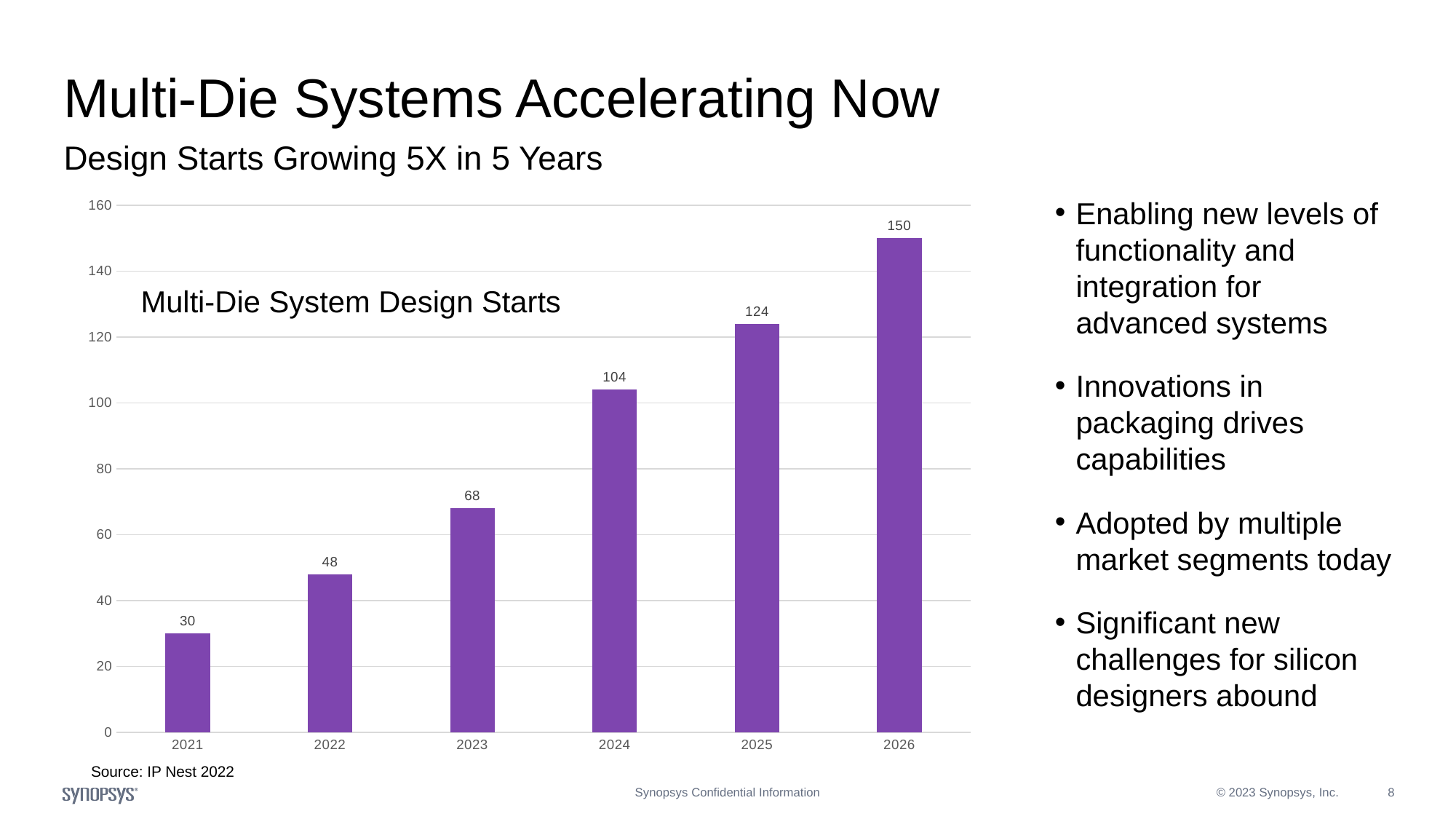
What kind of chart is shown on the slide? Bar chart Which year has the lowest value in the chart? 2021 Which is larger, the value for 2023 or the value for 2022? 2023 What is the value for 2021 in the Multi-Die System Design Starts chart? 30 What is the difference between the values for 2026 and 2021? 120 What is the difference between the values for 2025 and 2024? 20 How many years are shown on the x axis of the chart? 6 What is the value for 2024 in the Multi-Die System Design Starts chart? 104 Do the values rise or fall from 2021 to 2026? Rise Which year has the highest value in the chart? 2026 Is the value for 2025 greater or less than 120? greater What is the value for 2026 in the Multi-Die System Design Starts chart? 150